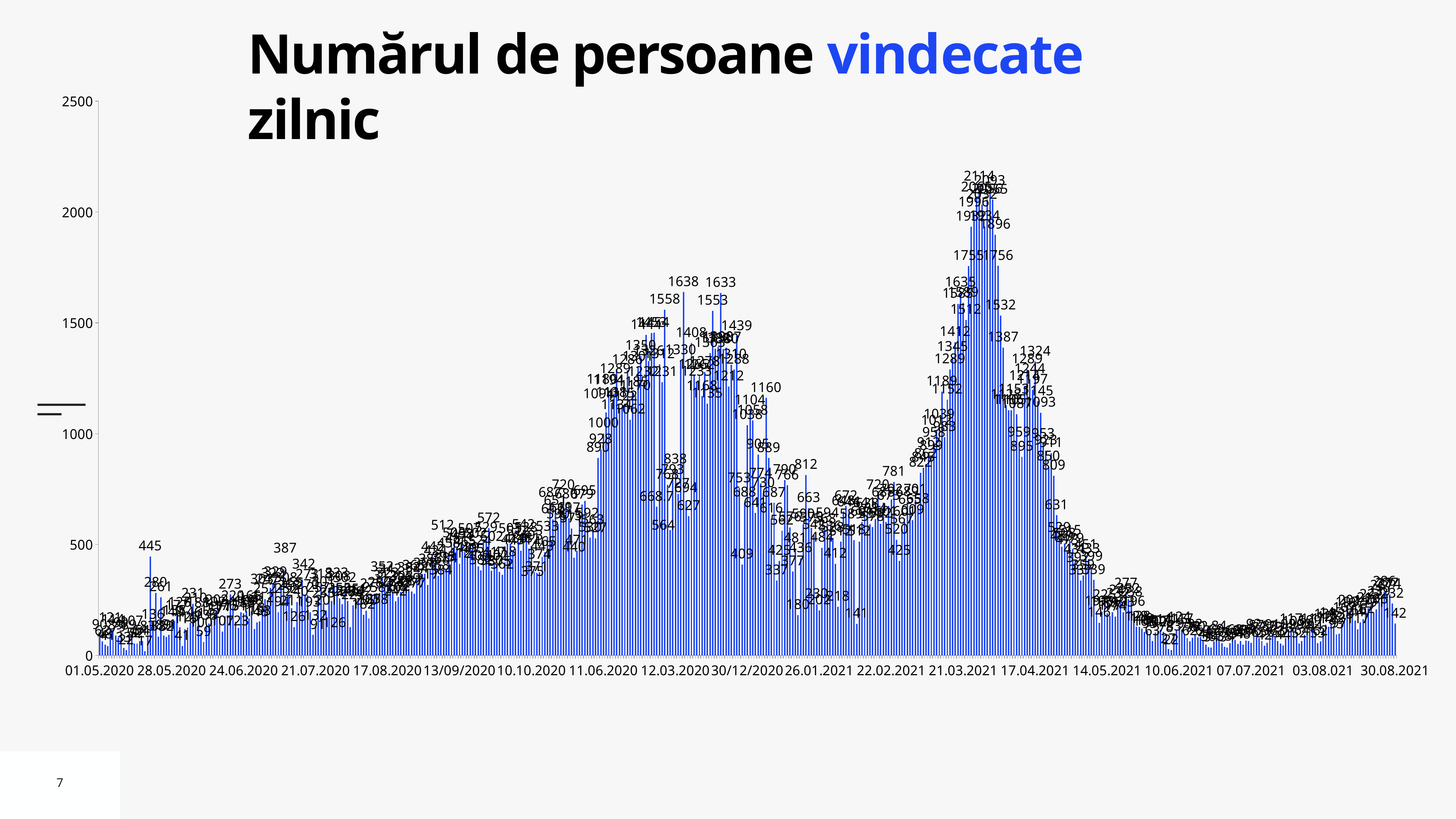
What kind of chart is shown on the slide? bar chart Do the values rise or fall along the x axis between 14.05.2021 and 10.06.2021? fall What is the difference between the labeled peak near 28.05.2020 (445) and the labeled peak of 387 between 24.06.2020 and 21.07.2020? 58 Is the value of the tallest bar on the chart greater or less than 2000? greater How many date labels are shown on the x axis? 19 Is the value for the last bar at 30.08.2021 greater or less than 500? less Which is larger: the peak labeled 2114 in April 2021 or the peak labeled 1638 in late 2020? 2114 What is the data label on the tallest bar near 28.05.2020? 445 What is the title of the chart? Numărul de persoane vindecate zilnic What is the data label on the last bar of the chart, at 30.08.2021? 142 What is the highest data label shown on the chart? 2114 What is the highest tick value shown on the y axis? 2500